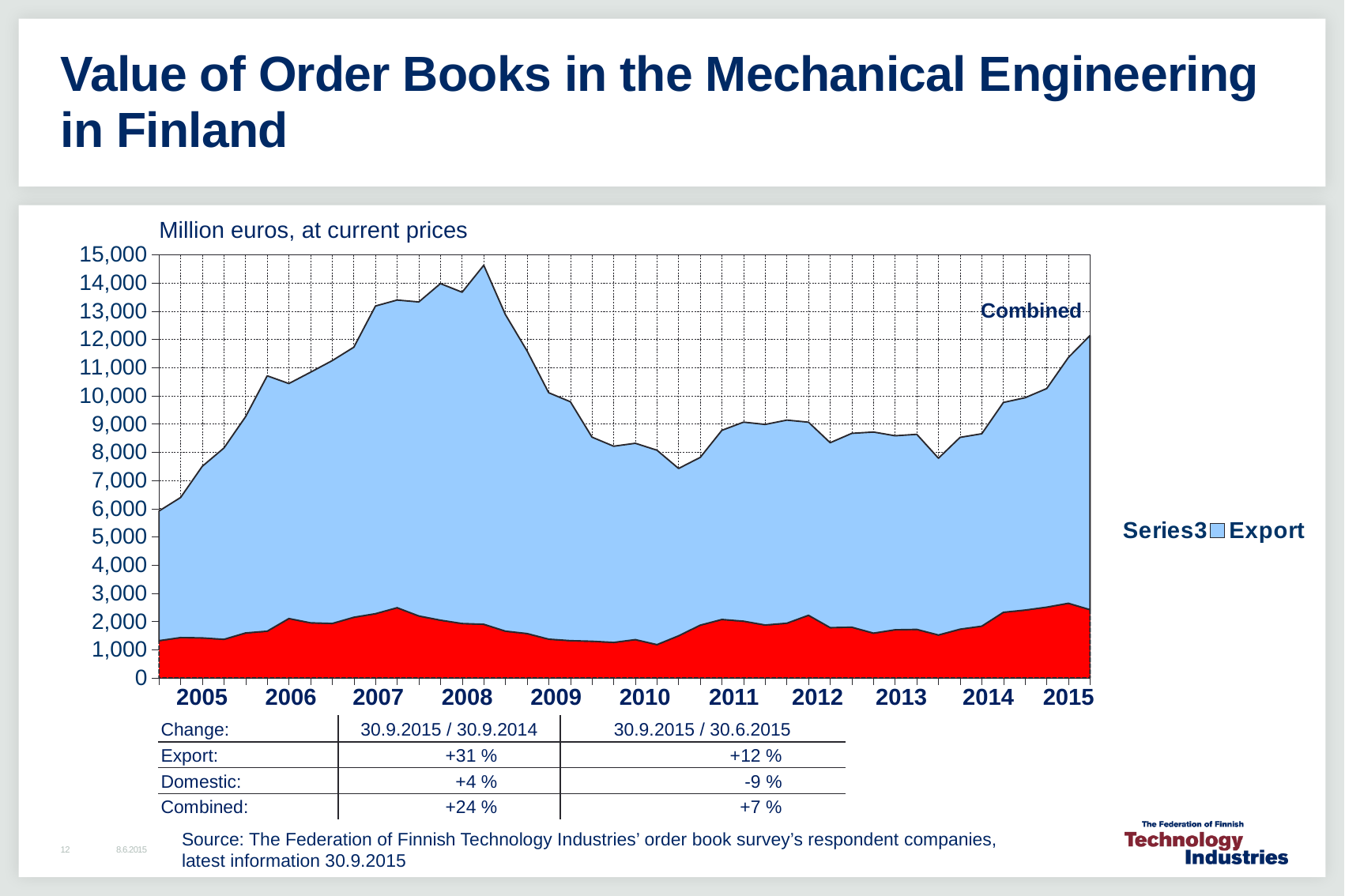
Is the Combined value at the start of 2005 greater or less than 7,000? less What kind of chart is shown on the slide? Area chart In which year does the Combined value reach its highest point? 2008 What unit is stated above the chart for the values? Million euros, at current prices In which year is the Combined value at its lowest? 2005 How many years are labelled on the x axis of the chart? 11 Is the lowest Combined value in 2010 greater or less than 8,000? less Does the Combined value rise or fall between 2005 and 2008? rise How many entries does the chart legend list? 2 Is the peak Combined value in 2008 greater or less than 14,000? greater Does the Combined value rise or fall between 2008 and 2009? fall